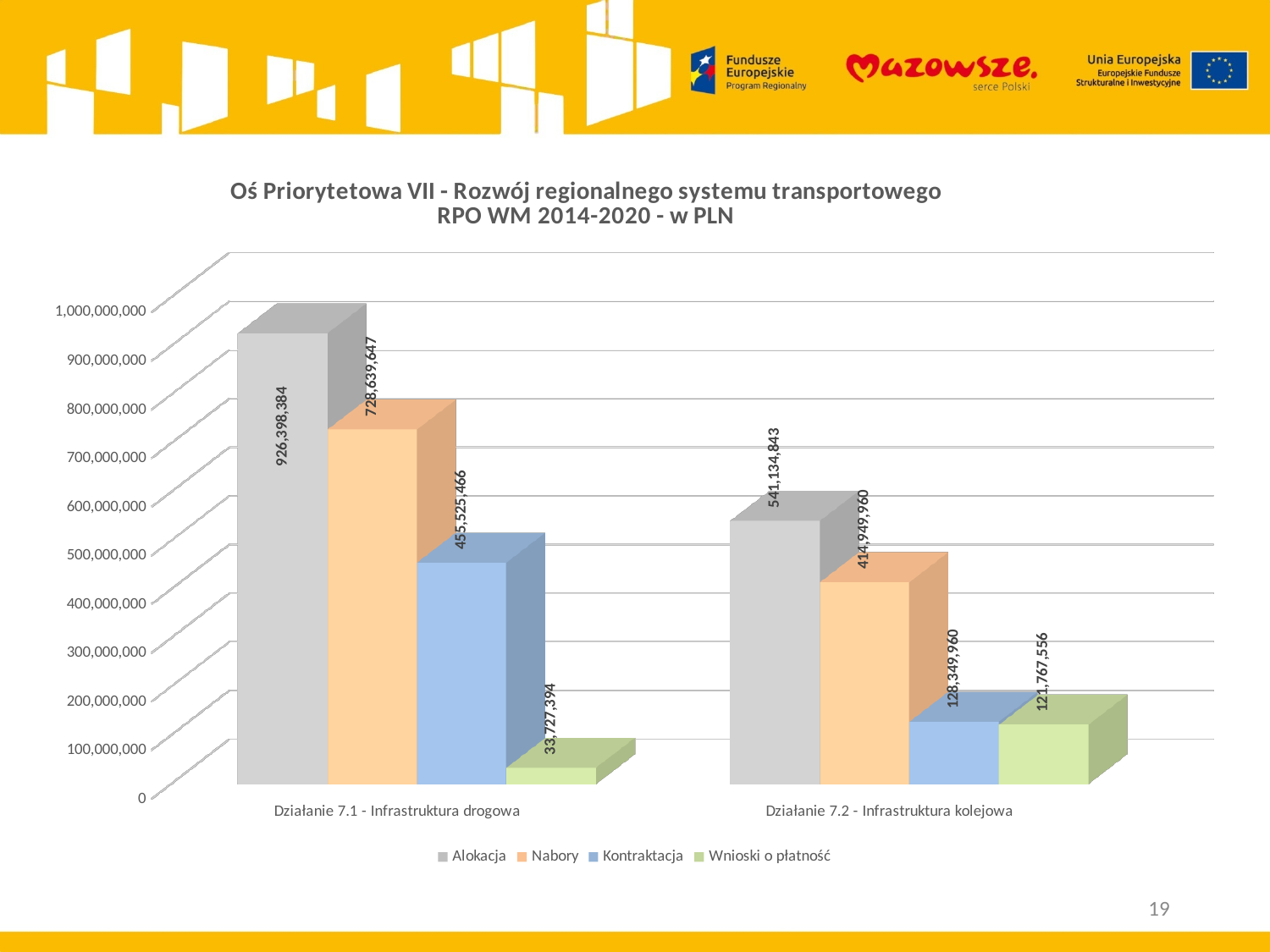
What is the Nabory value for Działanie 7.2 - Infrastruktura kolejowa? 414,949,960 What is the difference between the Nabory and Kontraktacja values for Działanie 7.1 - Infrastruktura drogowa? 273,114,181 What is the Wnioski o płatność value for Działanie 7.1 - Infrastruktura drogowa? 33,727,394 What is the difference between the Alokacja values for Działanie 7.1 and Działanie 7.2? 385,263,541 Which series has the highest value for Działanie 7.2 - Infrastruktura kolejowa? Alokacja How many categories are shown on the x axis? 2 How many series does the legend list? 4 Which series has the lowest value for Działanie 7.1 - Infrastruktura drogowa? Wnioski o płatność What kind of chart is shown on the slide? Bar chart What is the Alokacja value for Działanie 7.1 - Infrastruktura drogowa? 926,398,384 What is the Kontraktacja value for Działanie 7.2 - Infrastruktura kolejowa? 128,349,960 Which is larger: the Kontraktacja value for Działanie 7.1 or the Alokacja value for Działanie 7.2? Alokacja value for Działanie 7.2